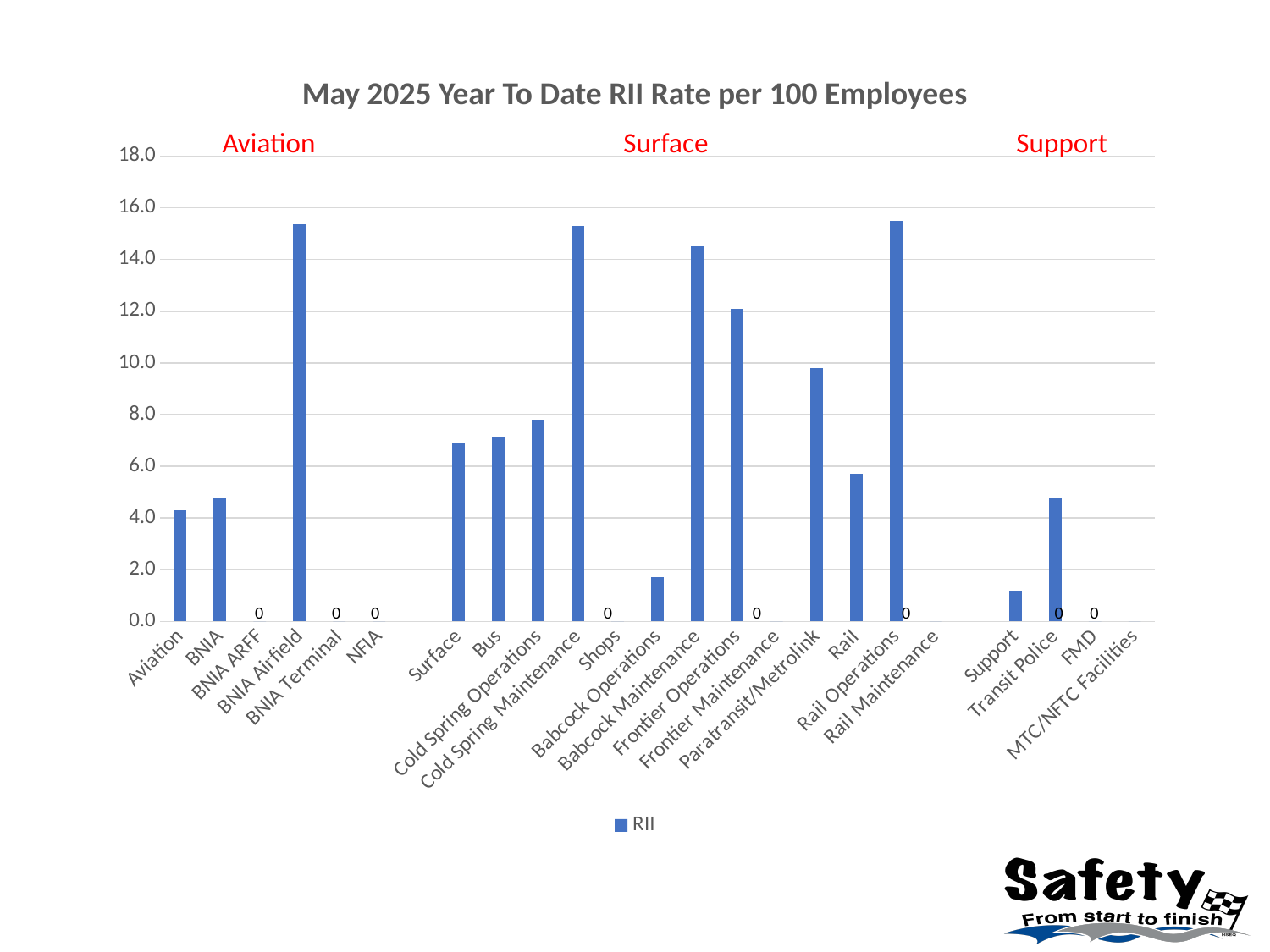
Which has the higher RII rate, Babcock Maintenance or Frontier Operations? Babcock Maintenance Is the value for Transit Police greater or less than 4.0? greater How many series does the legend list? 1 Is the value for Babcock Maintenance greater or less than 14.0? greater Which has the higher RII rate, Support or Transit Police? Transit Police What kind of chart is shown on the slide? bar chart What is the RII rate for BNIA ARFF? 0 How many categories are shown along the x axis? 23 What is the RII rate for Shops? 0 What is the RII rate for FMD? 0 Is the value for Babcock Operations greater or less than 2.0? less What is the title of the chart? May 2025 Year To Date RII Rate per 100 Employees